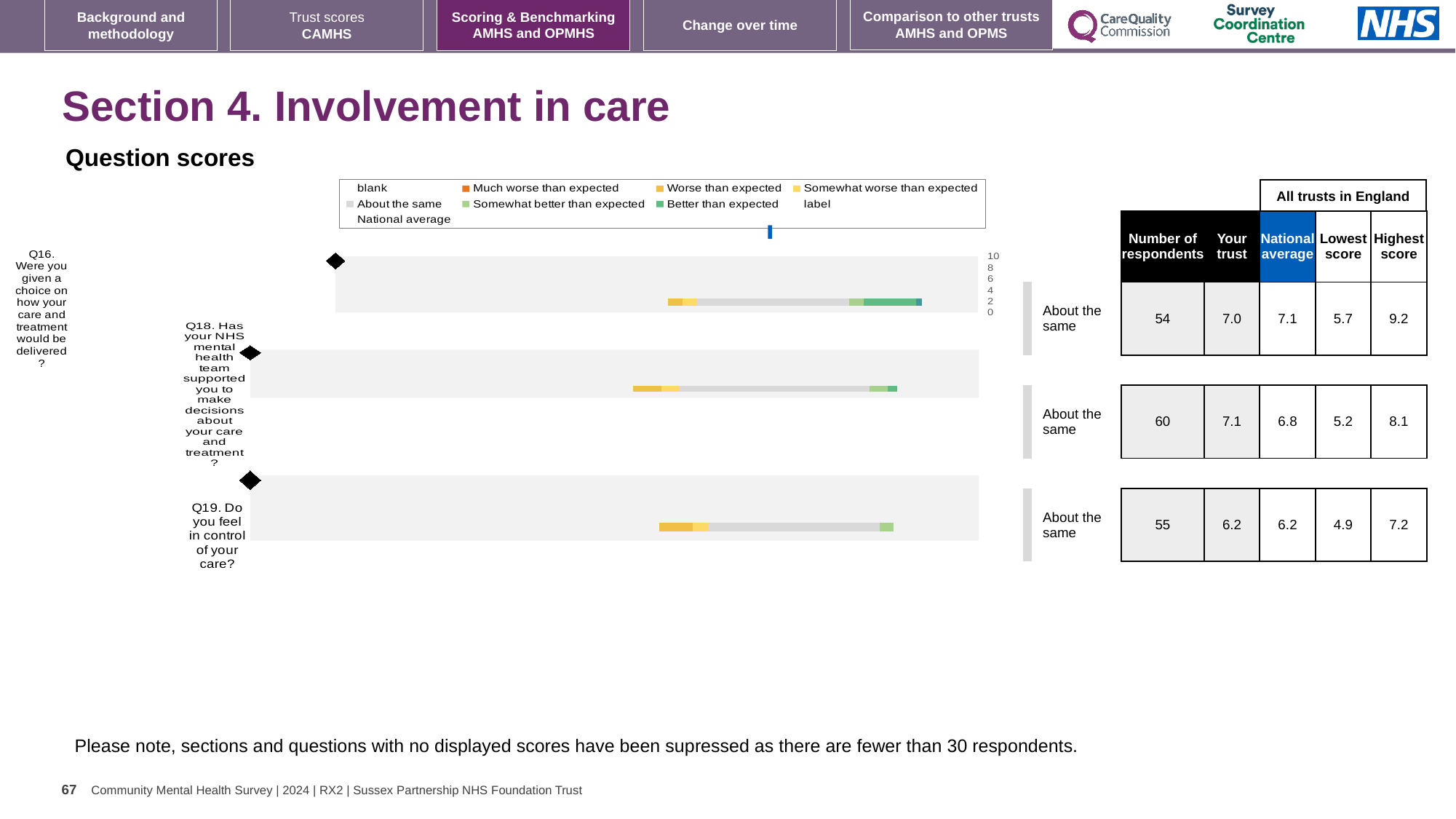
For Q18, which is larger: the 'Your trust' score or the national average? Your trust How many questions are plotted in the Question scores chart? 3 What is the difference between the highest score and the lowest score for Q16? 3.5 What is the number of respondents for Q16 (Were you given a choice on how your care and treatment would be delivered?)? 54 What kind of chart is used for the Question scores? bar chart What is the national average score for Q19 (Do you feel in control of your care?)? 6.2 In the Question scores chart legend, which entry is shown in dark green? Better than expected Which question has the highest 'Your trust' score? Q18 In the Question scores chart legend, which entry is shown in orange? Much worse than expected Which question has the lowest 'Your trust' score? Q19 What is the 'Your trust' score for Q18 (Has your NHS mental health team supported you to make decisions about your care and treatment?)? 7.1 What is the highest score among all trusts in England for Q16? 9.2